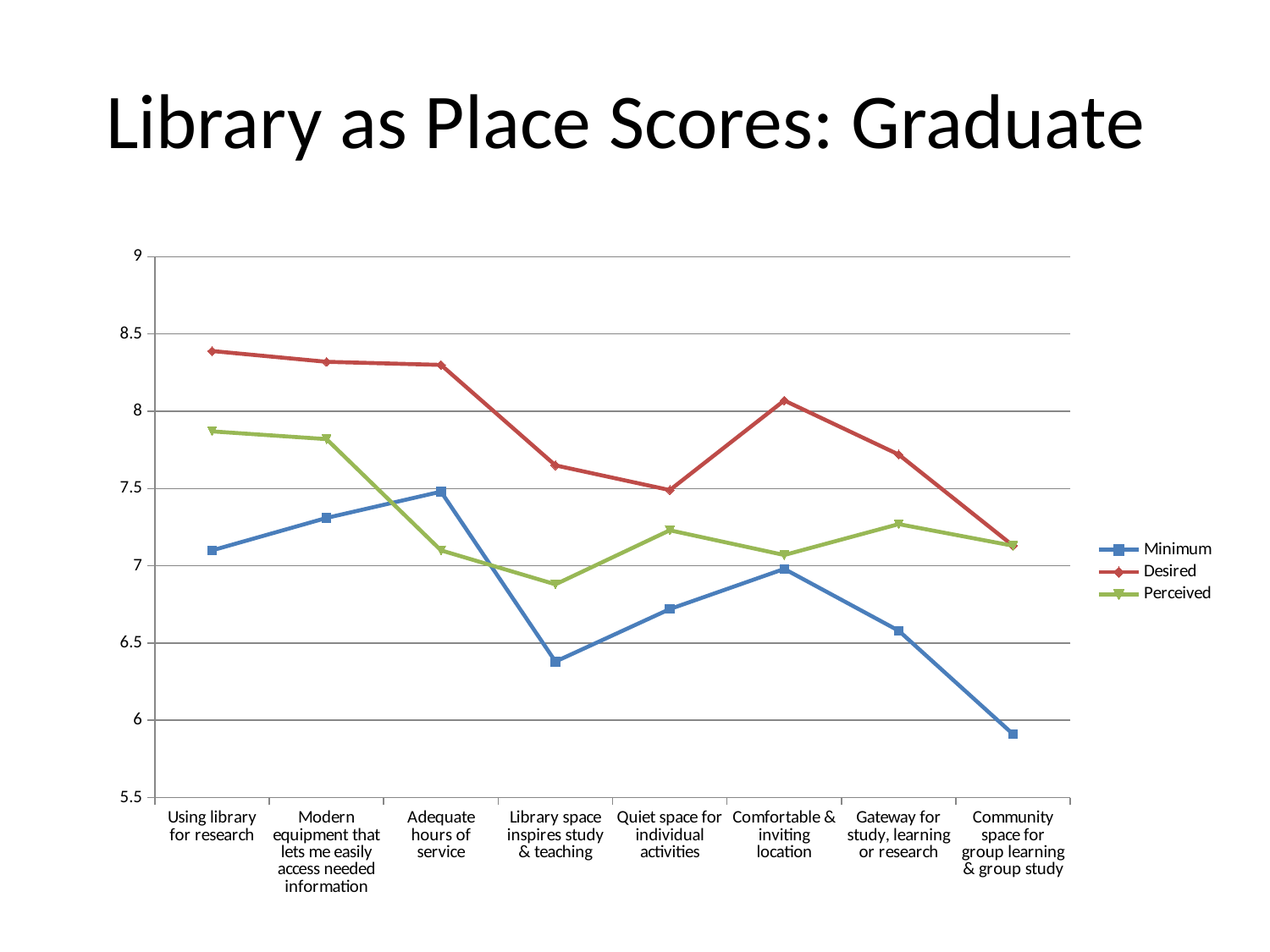
For which category is the Minimum series lowest? Community space for group learning & group study Is the Minimum value for Community space for group learning & group study greater or less than 6? less How many categories are plotted along the x axis? 8 Which series is drawn in red? Desired Is the Perceived value for Library space inspires study & teaching greater or less than 7? less What is the title of the chart? Library as Place Scores: Graduate Is the Minimum value for Library space inspires study & teaching greater or less than 6.5? less For Adequate hours of service, which is larger: the Minimum value or the Perceived value? Minimum What kind of chart is shown on the slide? line chart How many series does the legend list? 3 For which category is the Minimum series highest? Adequate hours of service